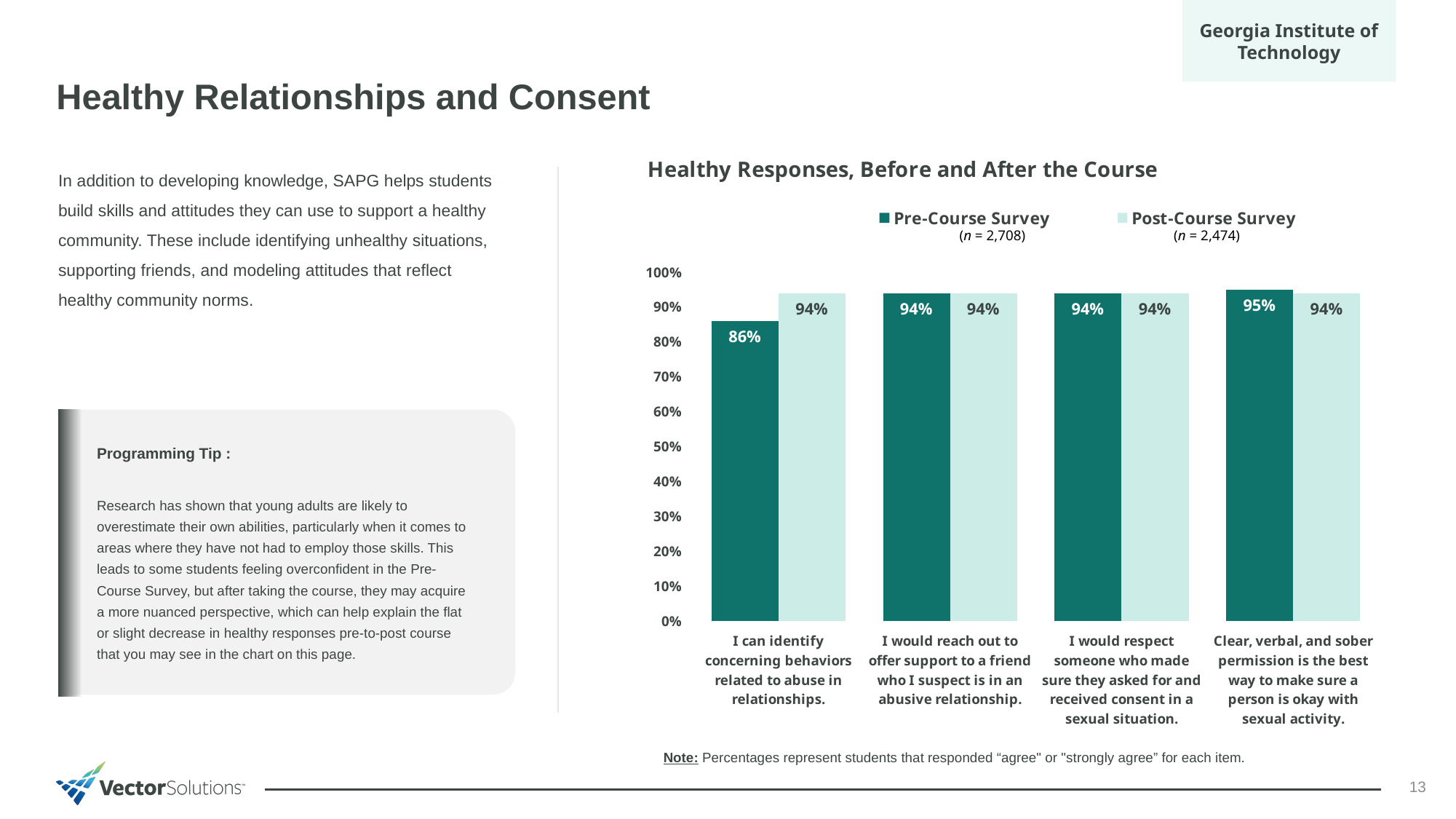
Which category has the highest Pre-Course Survey value? Clear, verbal, and sober permission is the best way to make sure a person is okay with sexual activity. How many series does the legend list? 2 What is the Post-Course Survey value for "I can identify concerning behaviors related to abuse in relationships."? 94% What is the difference between the Post-Course and Pre-Course Survey values for "I can identify concerning behaviors related to abuse in relationships."? 8% What is the title of the chart? Healthy Responses, Before and After the Course Which category has the lowest Pre-Course Survey value? I can identify concerning behaviors related to abuse in relationships. What is the Pre-Course Survey value for "I can identify concerning behaviors related to abuse in relationships."? 86% How many categories are shown on the x axis of the chart? 4 What is the Post-Course Survey value for "I would reach out to offer support to a friend who I suspect is in an abusive relationship."? 94% What is the Pre-Course Survey value for "Clear, verbal, and sober permission is the best way to make sure a person is okay with sexual activity."? 95% What kind of chart is shown on the slide? Bar chart For "Clear, verbal, and sober permission is the best way to make sure a person is okay with sexual activity.", which is larger: the Pre-Course Survey value or the Post-Course Survey value? Pre-Course Survey